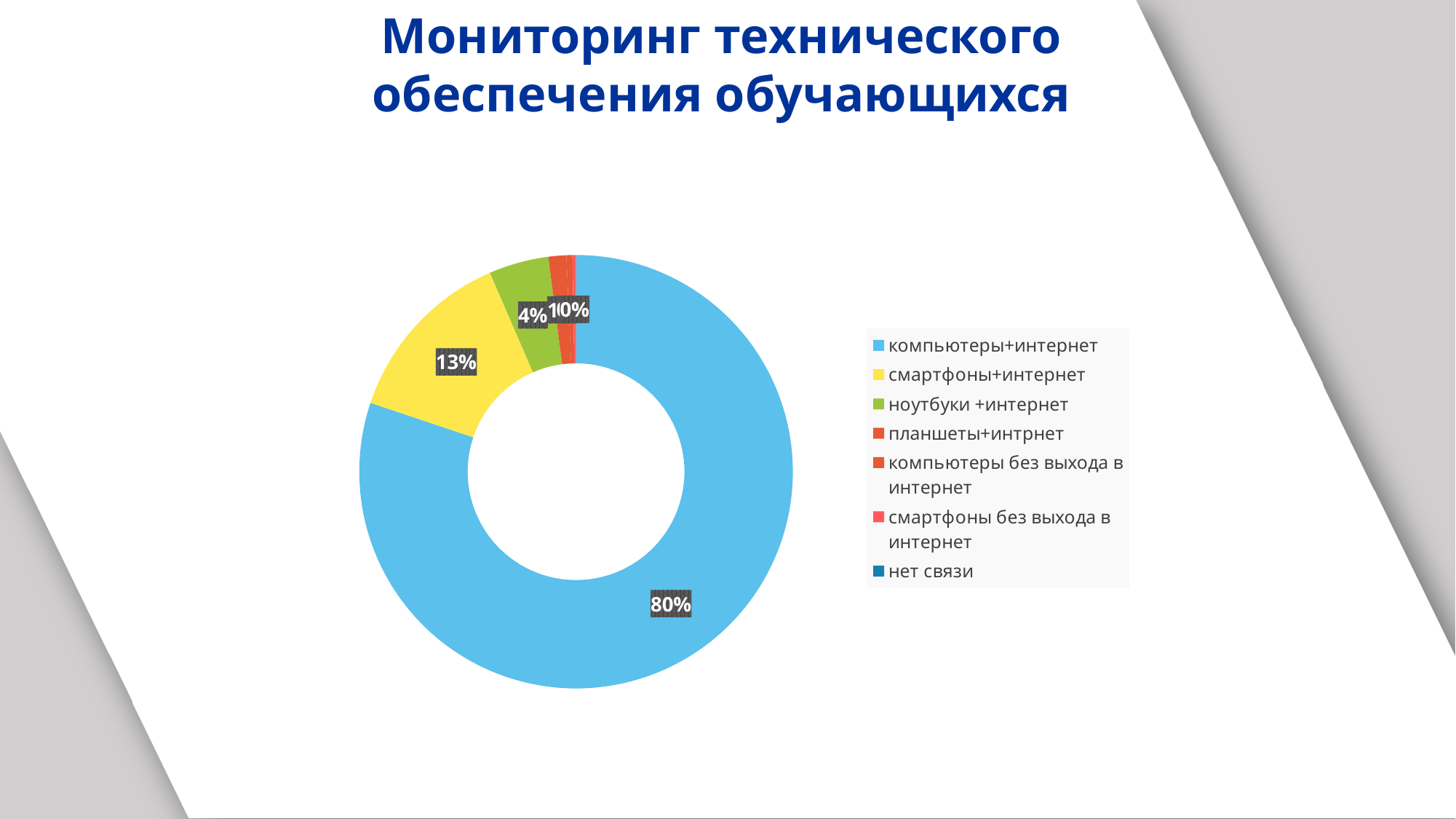
What colour represents компьютеры+интернет in the chart? blue What percentage of the chart is ноутбуки +интернет? 4% How many entries does the legend list? 7 What is the title of the slide? Мониторинг технического обеспечения обучающихся Which has a larger share, смартфоны+интернет or ноутбуки +интернет? смартфоны+интернет What percentage of the chart is компьютеры+интернет? 80% Which category has the largest share of the chart? компьютеры+интернет What is the difference in percentage points between компьютеры+интернет and смартфоны+интернет? 67 percentage points Is the share for компьютеры+интернет greater or less than 50%? greater What kind of chart is shown on the slide? doughnut (pie) chart What is the difference in percentage points between смартфоны+интернет and ноутбуки +интернет? 9 percentage points What percentage of the chart is смартфоны+интернет? 13%